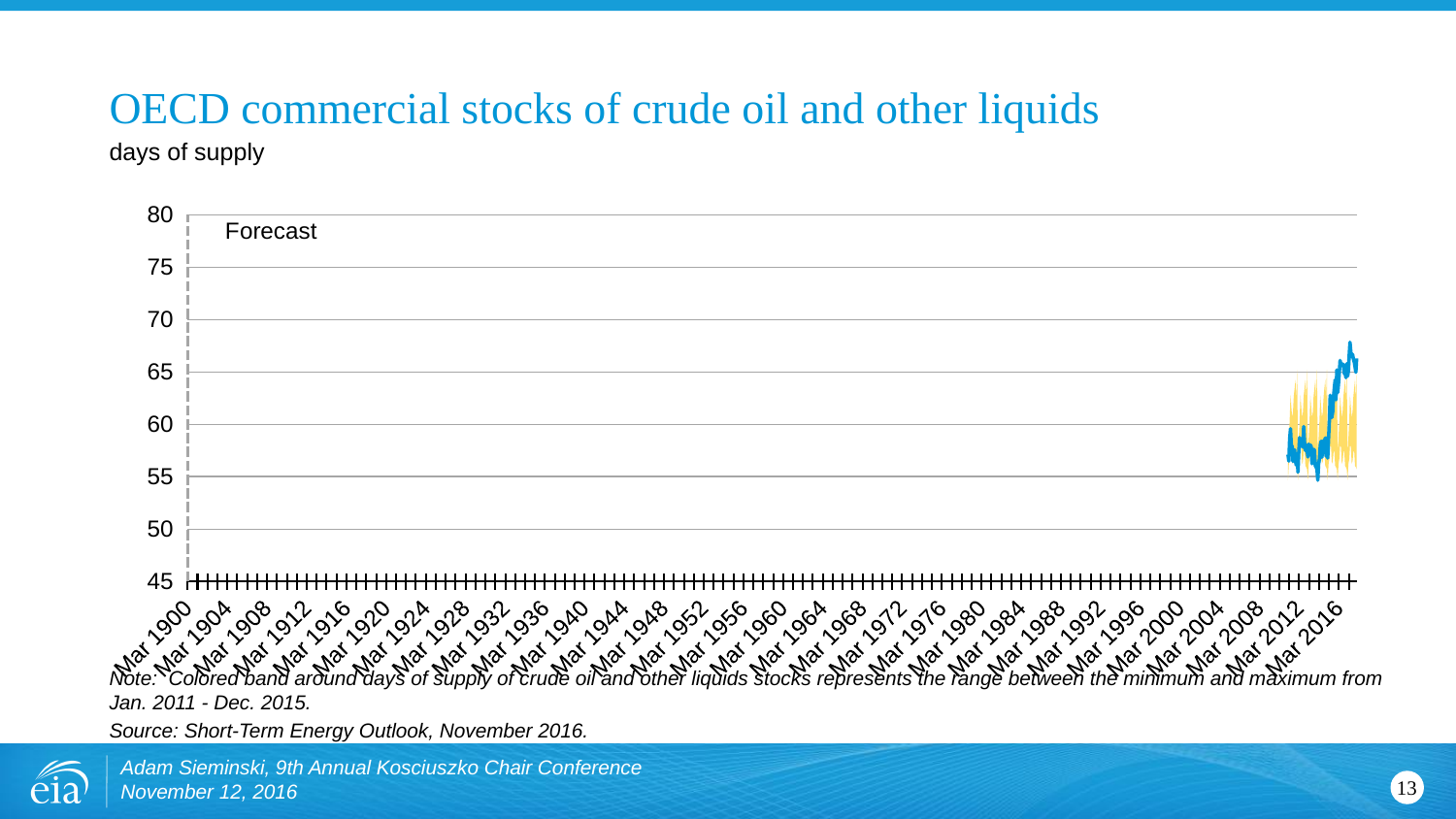
In what unit are the values on the chart measured, according to the subtitle? days of supply What kind of chart is shown on the slide? line chart What is the latest date label shown on the horizontal axis? Mar 2016 Is the peak of the blue line greater or less than 65? greater Is the value of the blue line at the far right end of the chart greater or less than 60? greater What is the source cited for the chart? Short-Term Energy Outlook, November 2016 What is the earliest date label shown on the horizontal axis? Mar 1900 What is the highest value shown on the vertical axis? 80 Does the blue line rise or fall over the final portion of the chart, toward Mar 2016? rise Is the value of the blue line at the far right end of the chart greater or less than 70? less What is the lowest value shown on the vertical axis? 45 What is the title of the chart? OECD commercial stocks of crude oil and other liquids